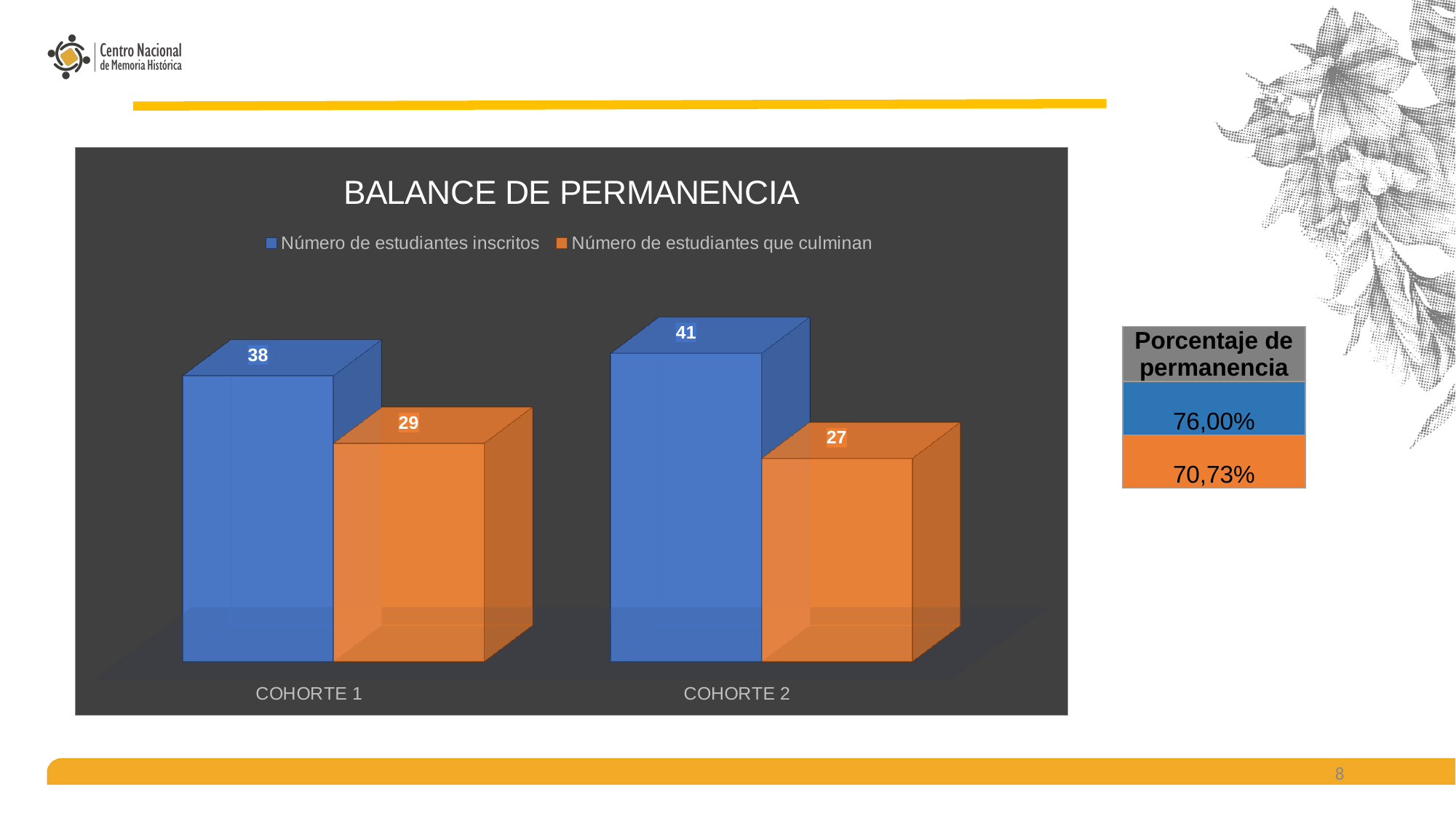
What is the value of 'Número de estudiantes inscritos' for COHORTE 1? 38 What is the difference between 'Número de estudiantes inscritos' and 'Número de estudiantes que culminan' for COHORTE 2? 14 What is the title of the chart? BALANCE DE PERMANENCIA How many series does the chart legend list? 2 What is the value of 'Número de estudiantes que culminan' for COHORTE 2? 27 What is the difference between 'Número de estudiantes inscritos' and 'Número de estudiantes que culminan' for COHORTE 1? 9 Which cohort has the lowest value for 'Número de estudiantes que culminan'? COHORTE 2 How many categories are shown on the x axis of the chart? 2 What is the value of 'Número de estudiantes que culminan' for COHORTE 1? 29 Which cohort has the highest value for 'Número de estudiantes inscritos'? COHORTE 2 Which is larger: 'Número de estudiantes inscritos' for COHORTE 1 or for COHORTE 2? COHORTE 2 What kind of chart is shown on the slide? Bar chart